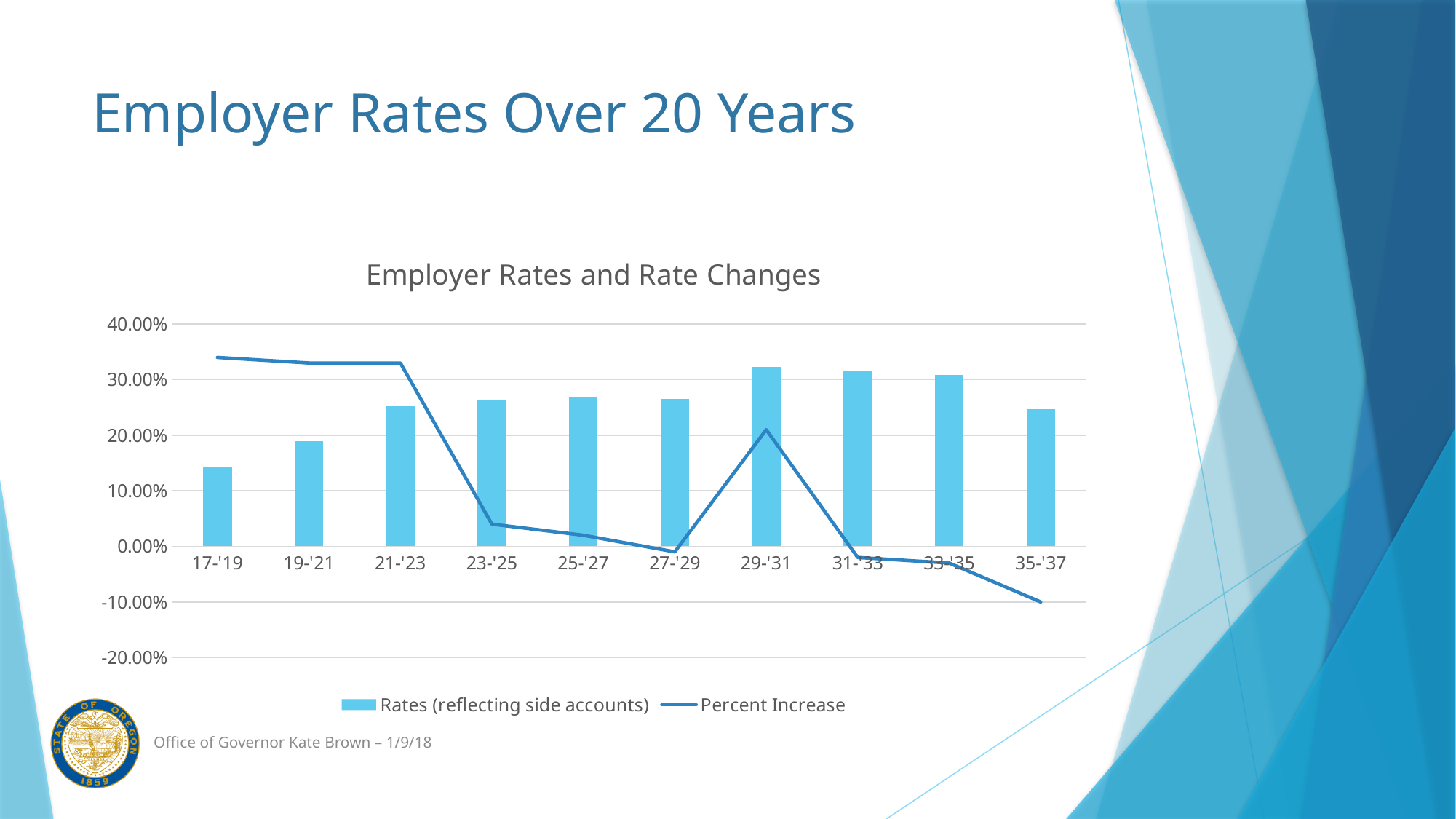
Is the Percent Increase value for 23-'25 greater or less than 10.00%? less How many periods are shown on the x axis? 10 Is the Rates (reflecting side accounts) bar for 17-'19 greater or less than 20.00%? less In which period is the Percent Increase line at its lowest? 35-'37 How many series does the legend list? 2 Which is larger, the Rates (reflecting side accounts) bar for 17-'19 or for 35-'37? 35-'37 Is the Percent Increase value for 35-'37 greater or less than 0.00%? less Does the Percent Increase line generally rise or fall from 17-'19 to 35-'37? fall What kind of chart is this? Combined bar and line chart Which period has the lowest bar for Rates (reflecting side accounts)? 17-'19 What is the title of the chart? Employer Rates and Rate Changes